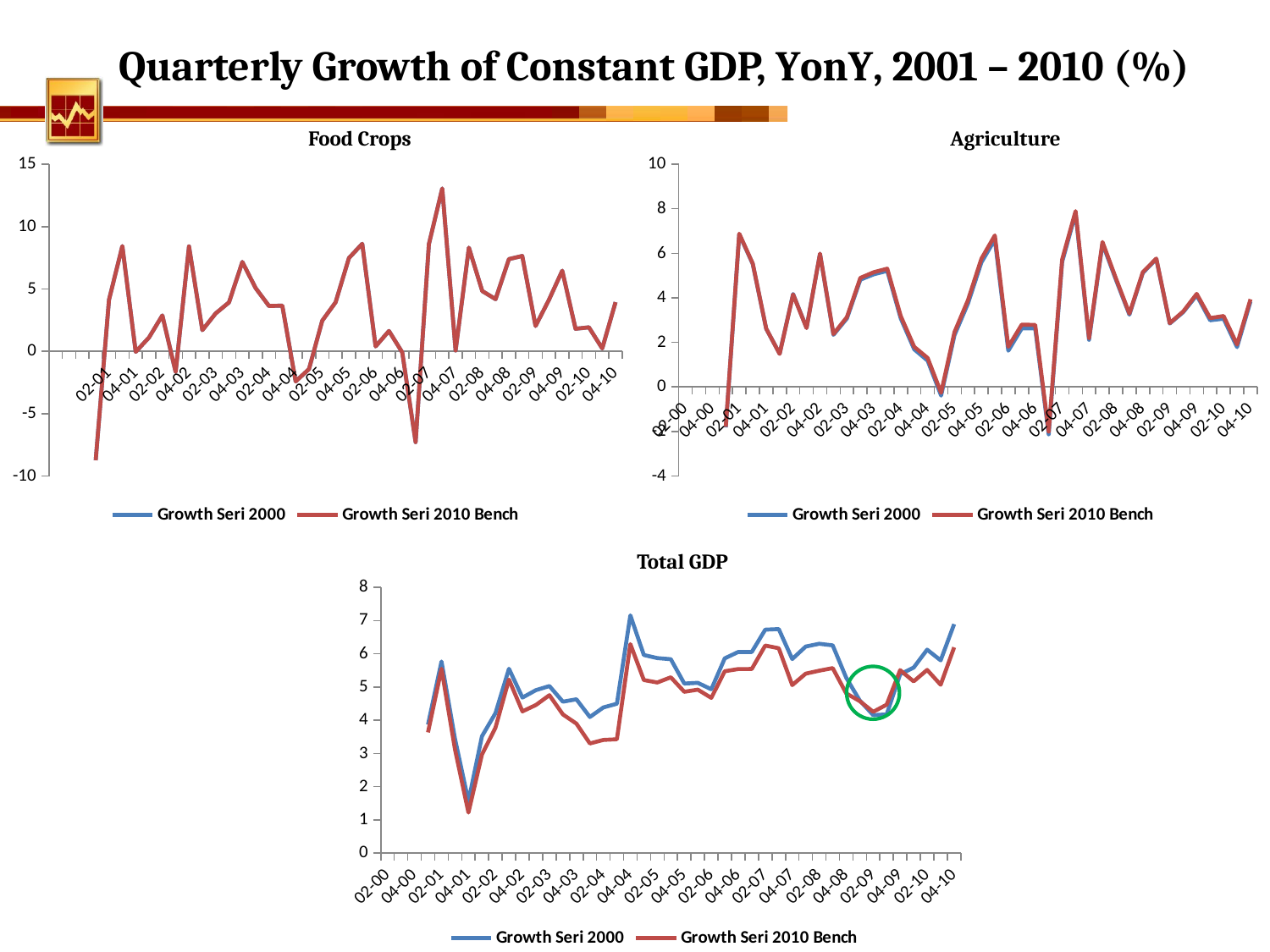
In the Total GDP chart, is the value for Growth Seri 2000 at 04-01 greater or less than 2? less In the Agriculture chart, is the value at 04-07 greater or less than 6? less What are the two series named in the legend of the Agriculture chart? Growth Seri 2000 and Growth Seri 2010 Bench How many series does the legend of the Total GDP chart list? 2 In the Total GDP chart, which series is higher at 04-04, Growth Seri 2000 or Growth Seri 2010 Bench? Growth Seri 2000 In the Total GDP chart, is the value for Growth Seri 2000 at 04-04 greater or less than 6? greater How many charts are shown on the slide? 3 What kind of chart is the Food Crops chart? line chart In the Total GDP chart, which quarter has the lowest value for Growth Seri 2010 Bench? 04-01